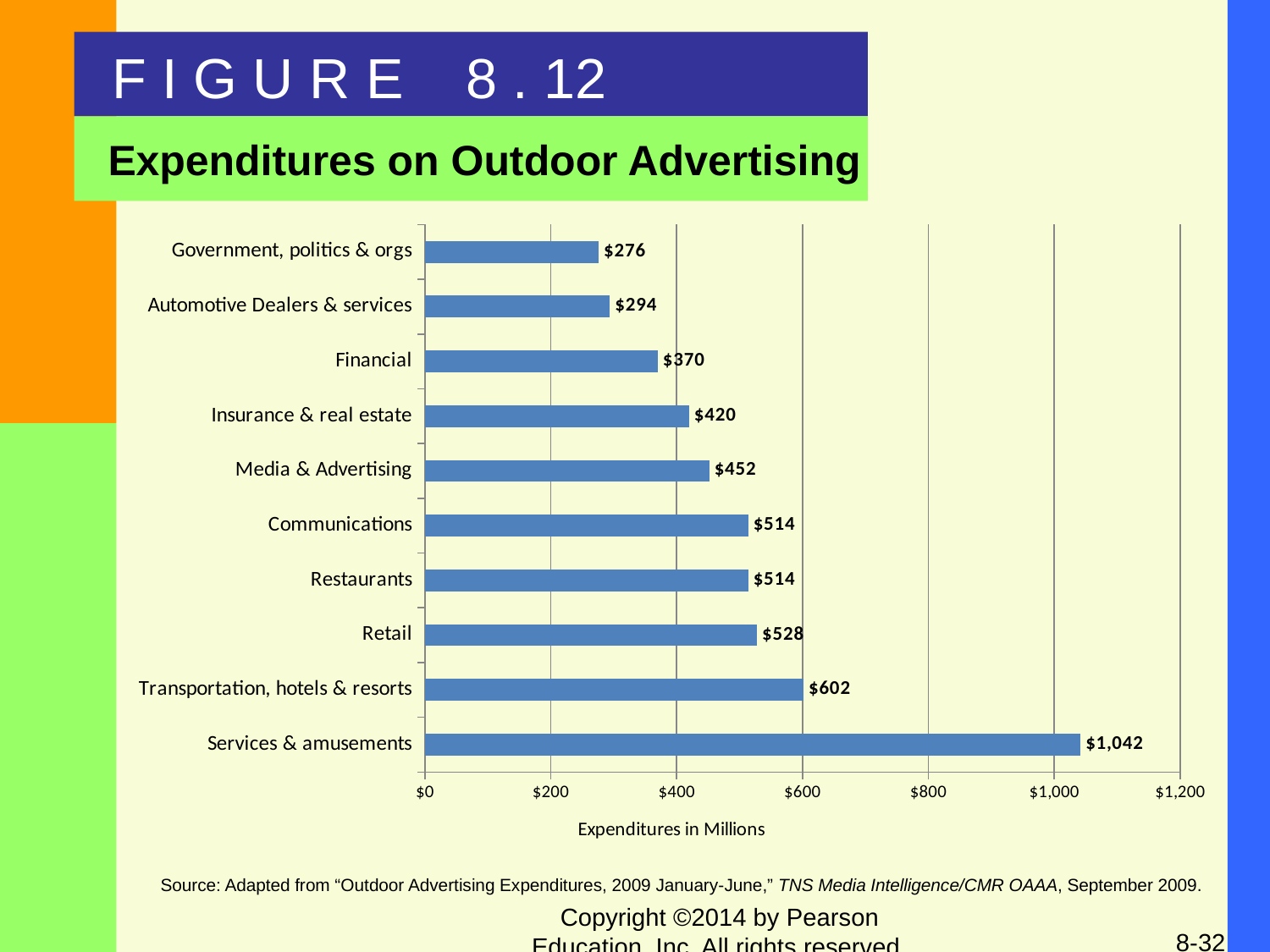
Which category has the highest expenditure on outdoor advertising? Services & amusements Is the value for Transportation, hotels & resorts greater or less than $800? less What is the expenditure value for Financial? $370 What is the difference between the expenditures for Insurance & real estate and Automotive Dealers & services? $126 What is the difference between the expenditures for Transportation, hotels & resorts and Retail? $74 Which category has the lowest expenditure on outdoor advertising? Government, politics & orgs How many categories are shown in the chart? 10 What is the expenditure value for Media & Advertising? $452 What kind of chart is shown on the slide? Bar chart What is the label on the horizontal axis of the chart? Expenditures in Millions What is the expenditure value for Services & amusements? $1,042 Which has a larger expenditure, Retail or Communications? Retail